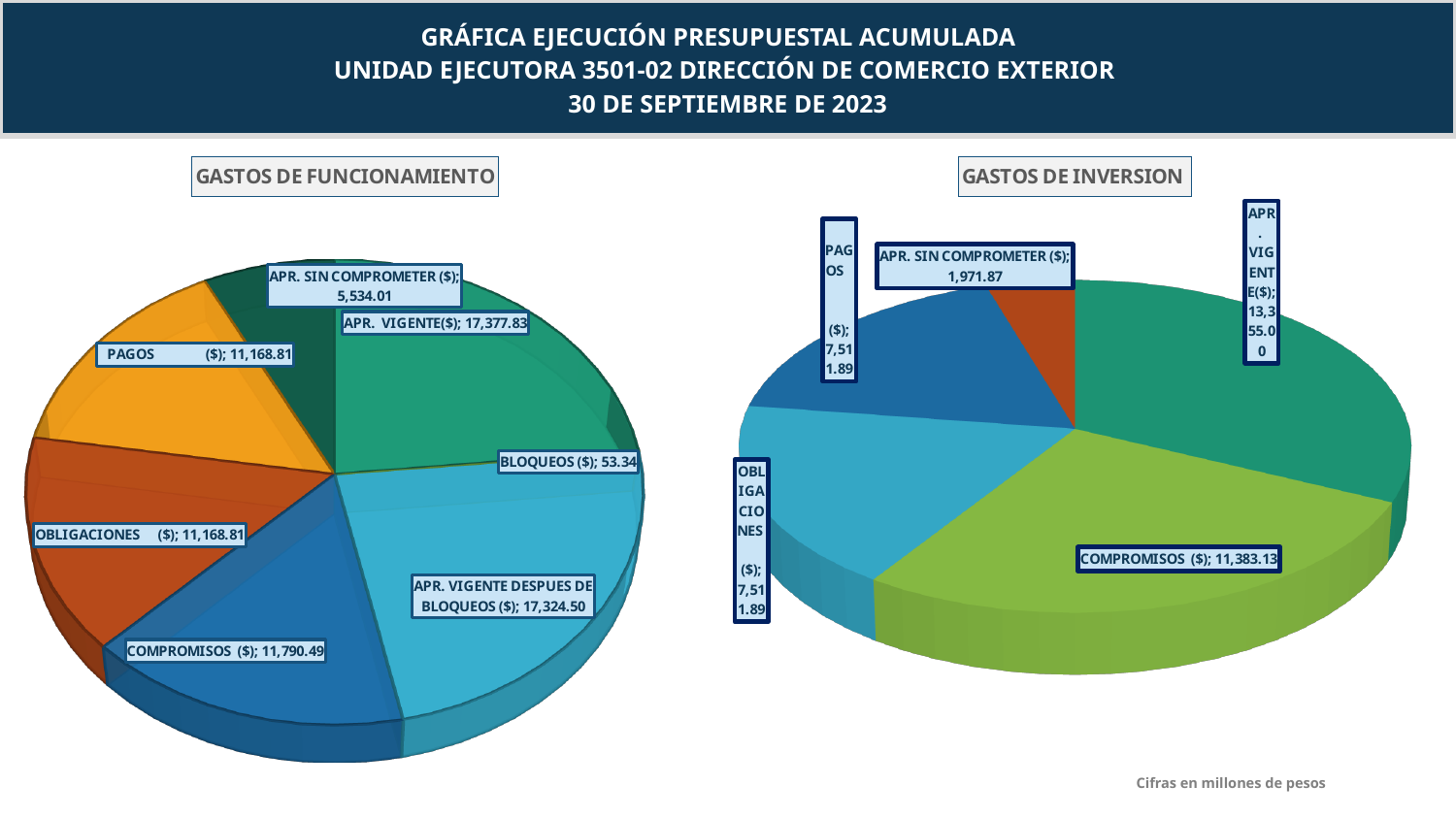
In the GASTOS DE FUNCIONAMIENTO chart, which category has the smallest value? BLOQUEOS In the GASTOS DE FUNCIONAMIENTO chart, what is the value for APR. SIN COMPROMETER? 5,534.01 In the GASTOS DE FUNCIONAMIENTO chart, what is the difference between APR. VIGENTE and APR. VIGENTE DESPUES DE BLOQUEOS? 53.33 What type of chart is used for GASTOS DE INVERSION? Pie chart In the GASTOS DE FUNCIONAMIENTO chart, which category has the largest value? APR. VIGENTE In the GASTOS DE FUNCIONAMIENTO chart, what is the value for COMPROMISOS? 11,790.49 How many slices does the GASTOS DE FUNCIONAMIENTO chart have? 7 In the GASTOS DE INVERSION chart, what is the value for COMPROMISOS? 11,383.13 In the GASTOS DE INVERSION chart, what is the difference between APR. VIGENTE and COMPROMISOS? 1,971.87 In the GASTOS DE FUNCIONAMIENTO chart, what is the value for BLOQUEOS? 53.34 In the GASTOS DE INVERSION chart, which is larger, COMPROMISOS or PAGOS? COMPROMISOS In the GASTOS DE INVERSION chart, what is the value for APR. SIN COMPROMETER? 1,971.87